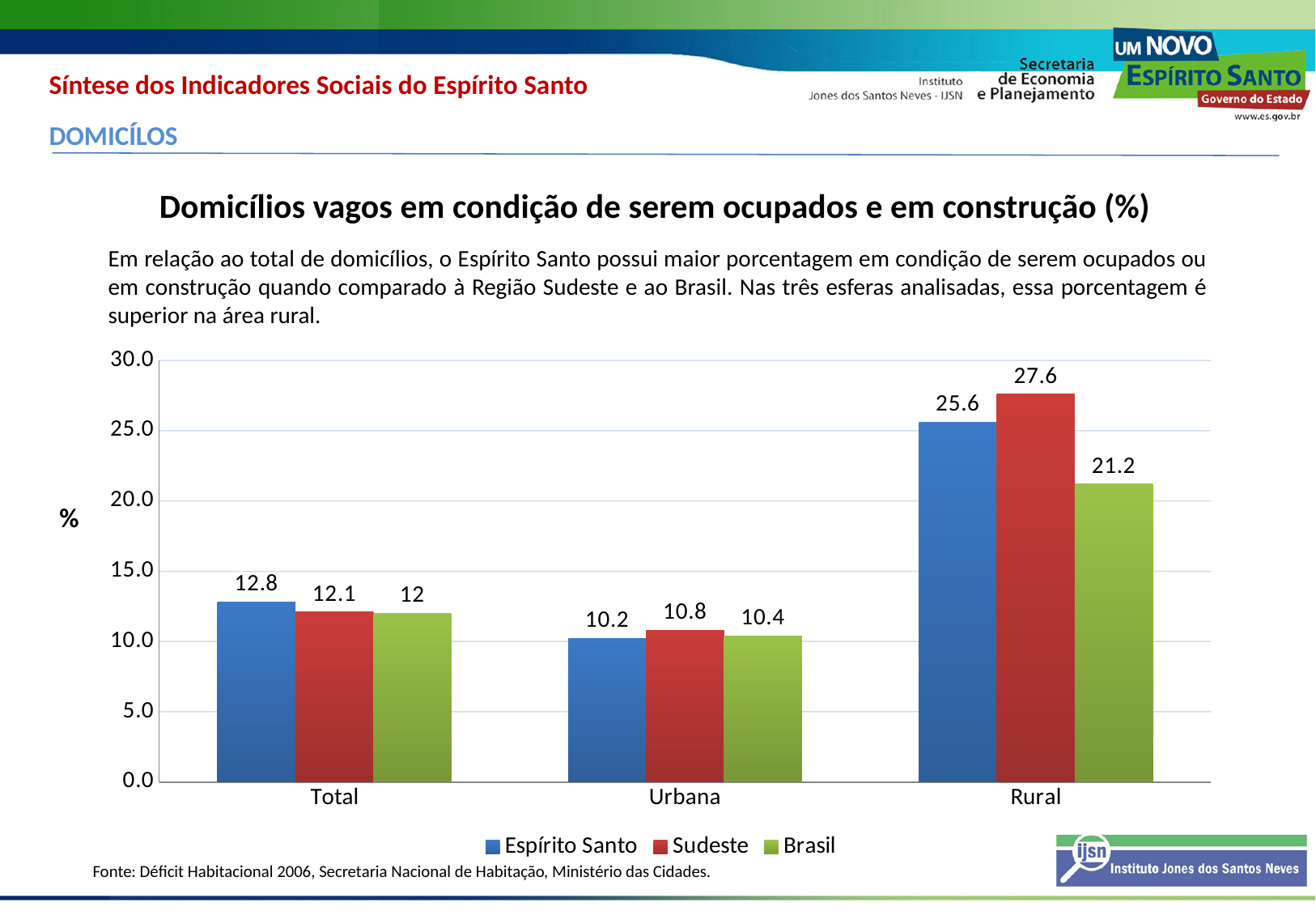
Which colour represents Sudeste in the chart? red Is the value for Brasil in the Rural category greater or less than 20.0? greater Which category has the highest value for Sudeste? Rural What is the value for Sudeste in the Urbana category? 10.8 What is the value for Espírito Santo in the Rural category? 25.6 How many series does the legend list? 3 In the Rural category, which is larger: Espírito Santo or Sudeste? Sudeste How many categories are shown on the x axis? 3 What is the value for Brasil in the Total category? 12 What kind of chart is shown on the slide? bar chart What is the difference between the Sudeste and Brasil values in the Rural category? 6.4 Which category has the lowest value for Espírito Santo? Urbana